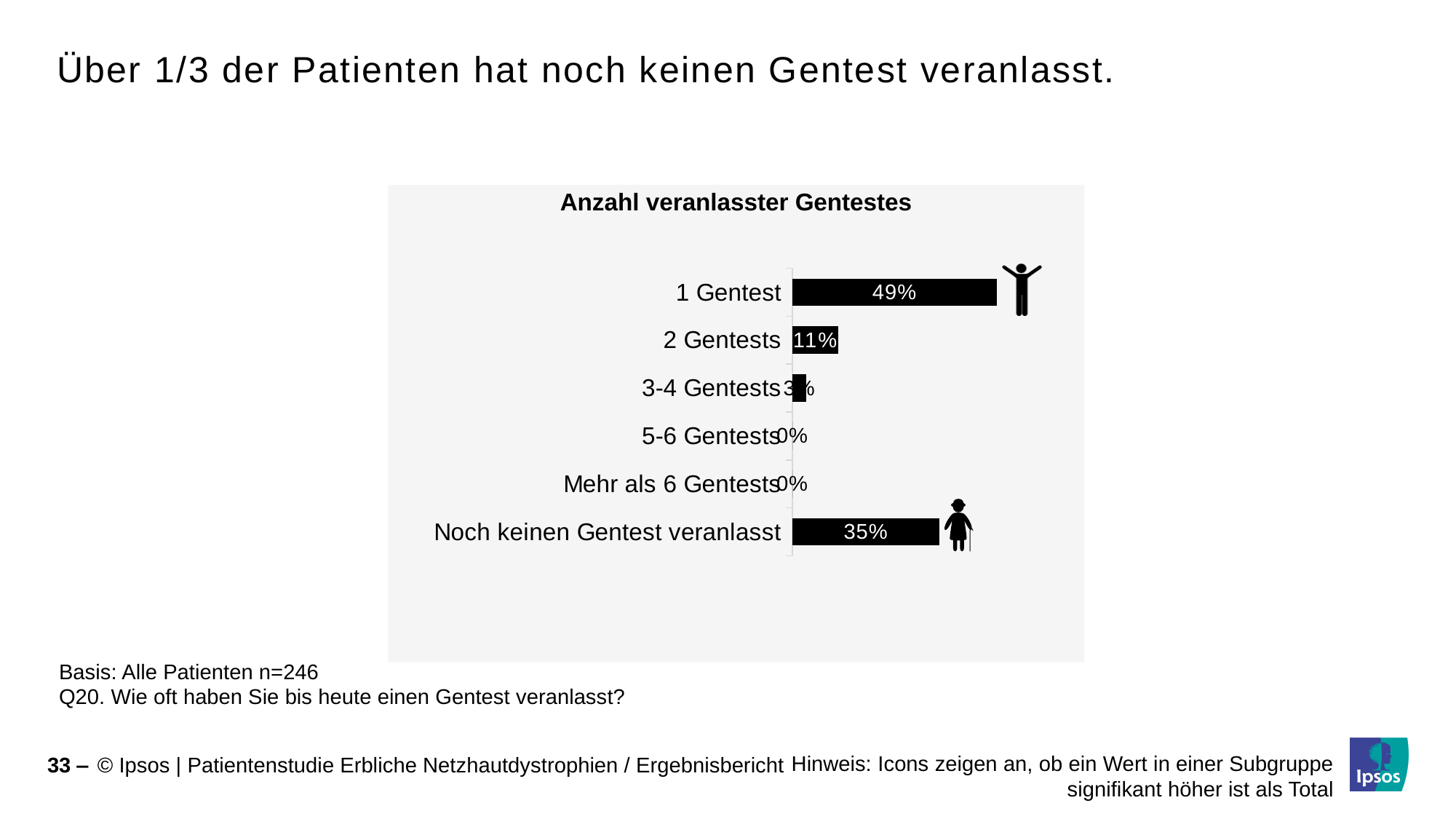
What is the difference between the values for "2 Gentests" and "3-4 Gentests"? 8% What is the value for "3-4 Gentests"? 3% What is the title of the chart? Anzahl veranlasster Gentestes What is the value for "5-6 Gentests"? 0% What is the value for "1 Gentest"? 49% What is the value for "Noch keinen Gentest veranlasst"? 35% What is the value for "2 Gentests"? 11% Which is larger, the value for "2 Gentests" or the value for "Noch keinen Gentest veranlasst"? Noch keinen Gentest veranlasst Which category has the highest value? 1 Gentest What is the difference between the values for "1 Gentest" and "Noch keinen Gentest veranlasst"? 14% How many categories are shown in the chart? 6 What kind of chart is shown? Bar chart